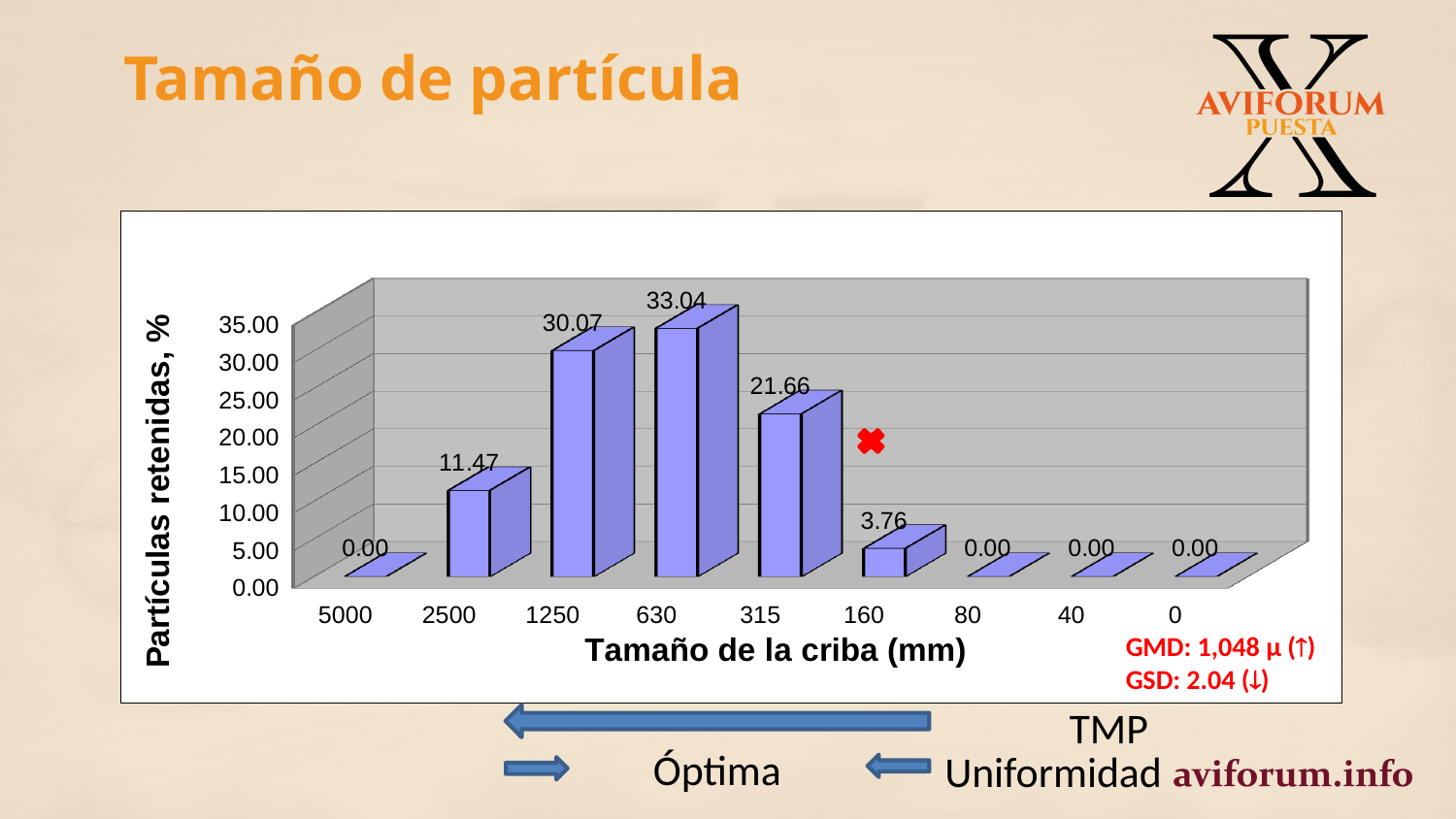
Which sieve size has the highest percentage of retained particles? 630 Is the value for 315 greater or less than 20.00? greater How many categories have a value of 0.00? 4 What is the value for the 630 sieve size? 33.04 How many sieve size categories are shown on the x axis? 9 What is the label of the y axis? Partículas retenidas, % What is the label of the x axis? Tamaño de la criba (mm) Which is larger, the value for 1250 or the value for 630? 630 What is the value for the 2500 sieve size? 11.47 What is the difference between the values for 1250 and 315? 8.41 What is the value for the 160 sieve size? 3.76 What kind of chart is shown on the slide? bar chart